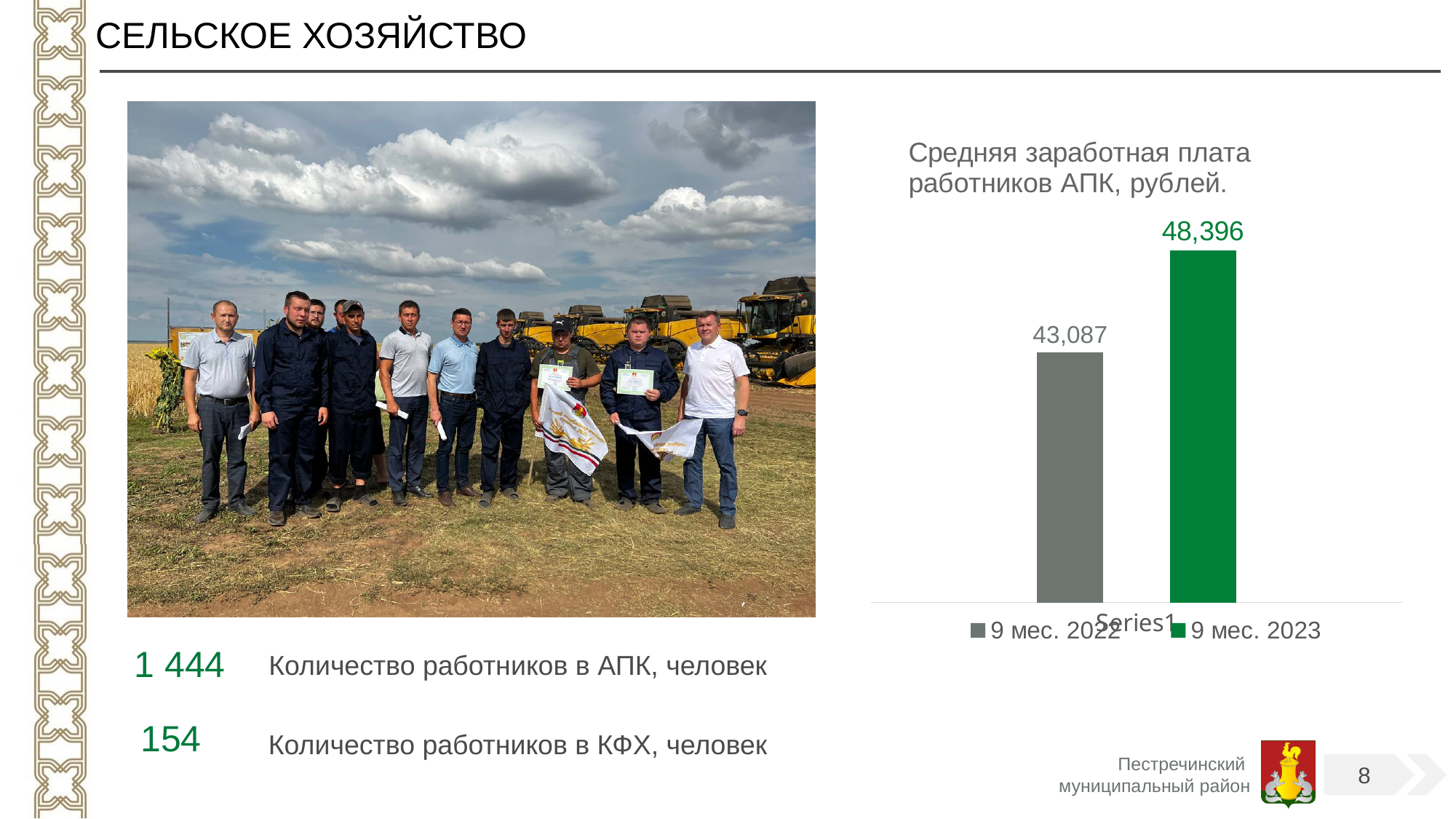
What colour is the bar for 9 мес. 2023? green Which period has the higher average salary on the chart, 9 мес. 2022 or 9 мес. 2023? 9 мес. 2023 How many entries does the chart legend list? 2 What is the title of the chart on the slide? Средняя заработная плата работников АПК, рублей. Does the average salary rise or fall from 9 мес. 2022 to 9 мес. 2023? rise Is the value for 9 мес. 2022 larger or smaller than the value for 9 мес. 2023? smaller What is the average salary of agro-industrial workers for 9 months of 2022 according to the chart? 43,087 What type of chart is shown on the slide? bar chart By how much does the average salary for 9 months of 2023 exceed that for 9 months of 2022? 5,309 How many bars are plotted on the chart? 2 What is the average salary of agro-industrial workers for 9 months of 2023 according to the chart? 48,396 Which period has the lower average salary on the chart? 9 мес. 2022